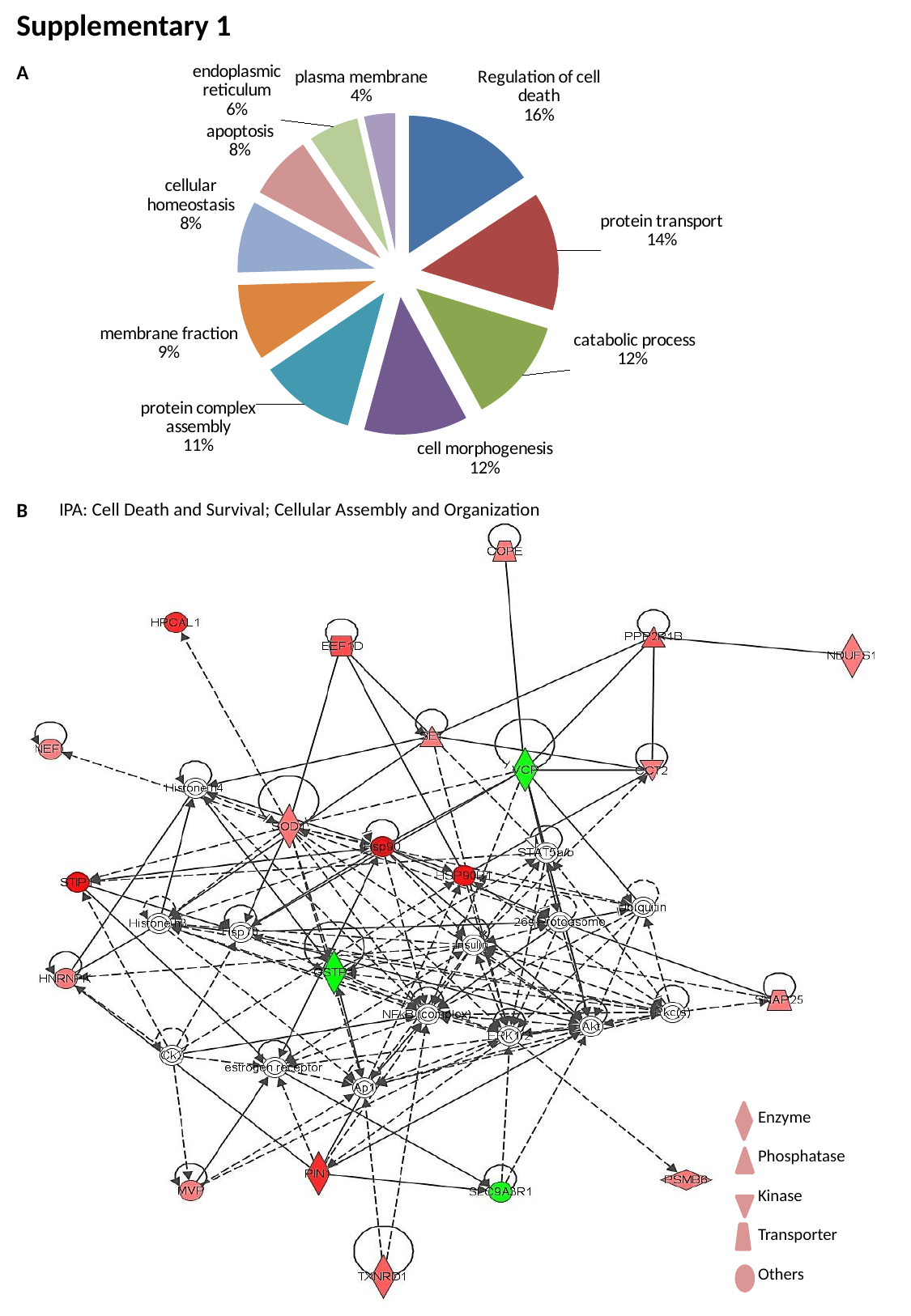
In the pie chart in panel A, what is the difference in percentage points between Regulation of cell death and protein transport? 2 In the pie chart in panel A, what percentage is shown for protein complex assembly? 11% In the pie chart in panel A, which category has the smallest share? plasma membrane In the pie chart in panel A, which has the larger share, catabolic process or apoptosis? catabolic process In the network diagram in panel B, how many shape categories does the legend list? 5 In the pie chart in panel A, what percentage is shown for protein transport? 14% In the pie chart in panel A, what percentage is shown for membrane fraction? 9% How many categories are shown in the pie chart in panel A? 10 In the pie chart in panel A, what is the difference in percentage points between membrane fraction and plasma membrane? 5 In the pie chart in panel A, which category has the largest share? Regulation of cell death What type of chart is shown in panel A? pie chart In the pie chart in panel A, what share is labelled for Regulation of cell death? 16%